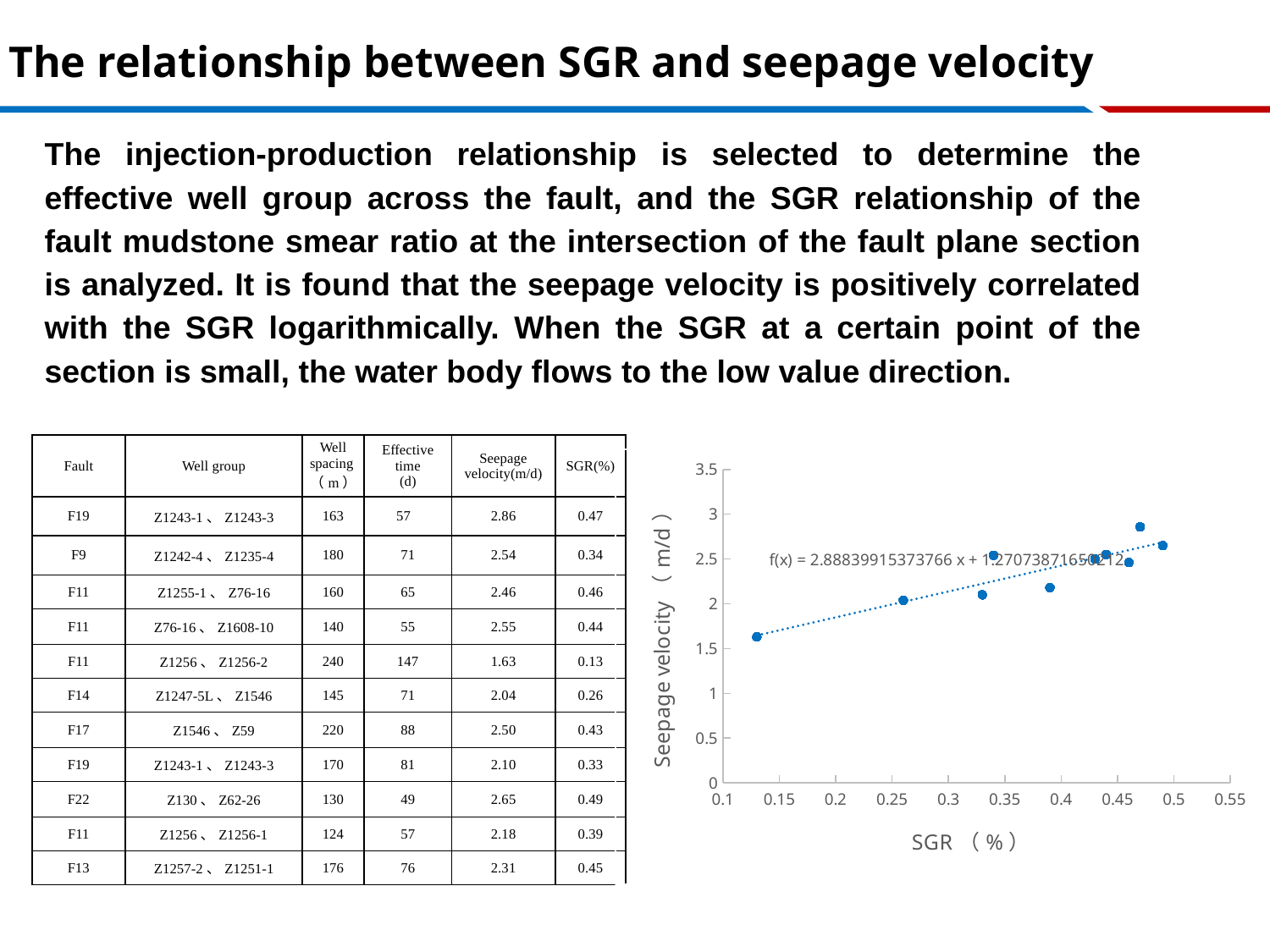
What is the highest tick value shown on the y axis of the scatter chart? 3.5 Is the seepage velocity of the leftmost point on the scatter chart (near SGR 0.13) greater or less than 2? less Is the seepage velocity of the rightmost point on the scatter chart (near SGR 0.49) greater or less than 2.5? greater Is the point with the lowest seepage velocity on the scatter chart at the low or high end of the SGR range? low end Is the seepage velocity of the highest point on the scatter chart (near SGR 0.47) greater or less than 2.5? greater What is the label of the x axis of the scatter chart? SGR (%) What is the slope of the fitted trendline equation shown on the scatter chart? 2.88839915373766 What kind of chart is shown on the right of the slide? scatter chart What is the label of the y axis of the scatter chart? Seepage velocity (m/d) Does seepage velocity rise or fall as SGR increases along the x axis of the scatter chart? rise